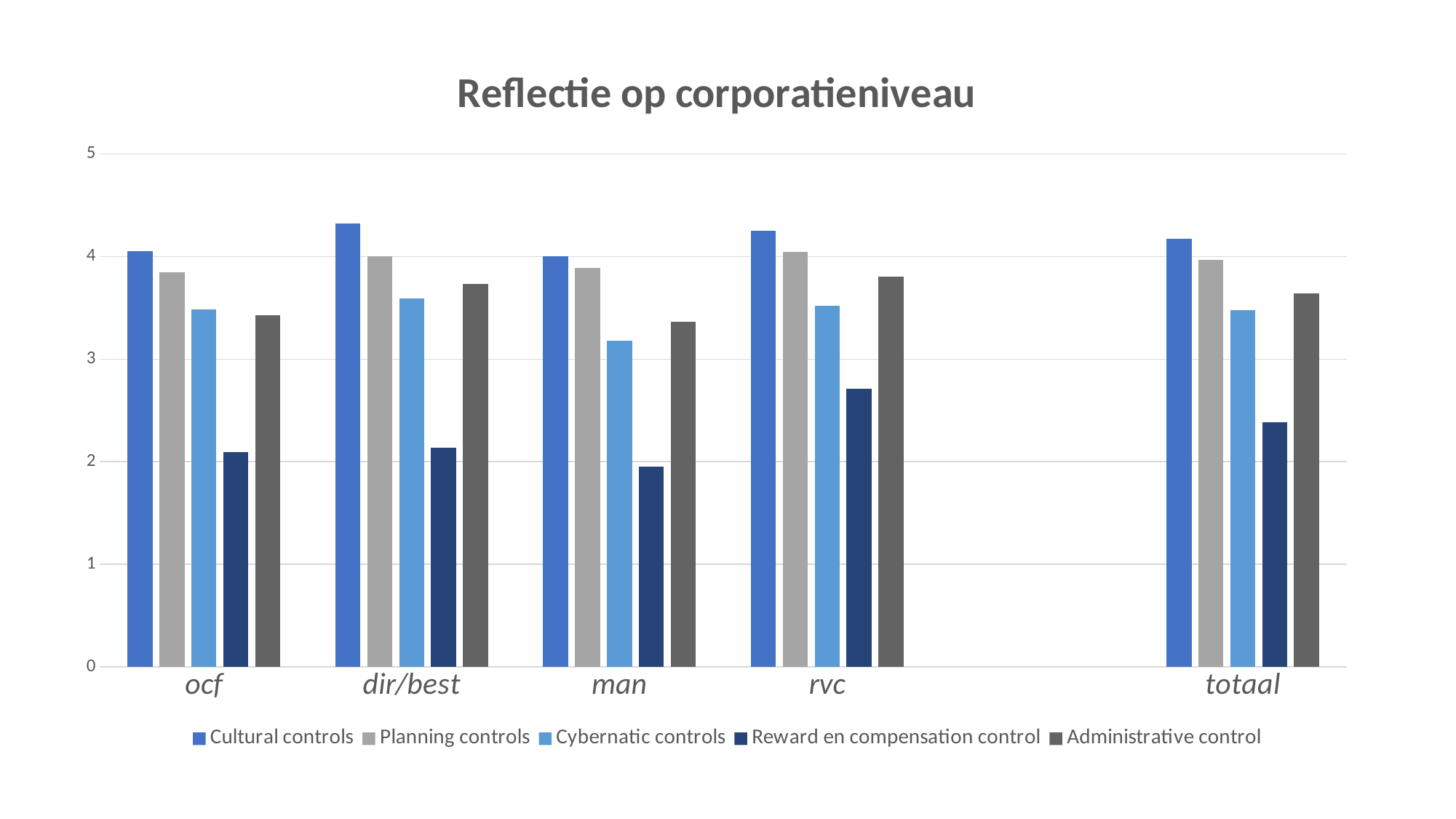
What kind of chart is shown on the slide? bar chart Which series has the lowest value in the ocf category? Reward en compensation control Which is larger: Cybernatic controls for dir/best or Cybernatic controls for man? dir/best Which is larger: Administrative control for rvc or Administrative control for ocf? rvc How many series does the legend list? 5 What is the title of the chart? Reflectie op corporatieniveau How many categories are shown on the x axis? 5 Is the value for Administrative control in ocf greater or less than 4? less For the Reward en compensation control series, which category has the highest value? rvc Is the value for Cultural controls in dir/best greater or less than 4? greater Which series has the highest value in the totaal category? Cultural controls Is the value for Reward en compensation control in rvc greater or less than 2? greater